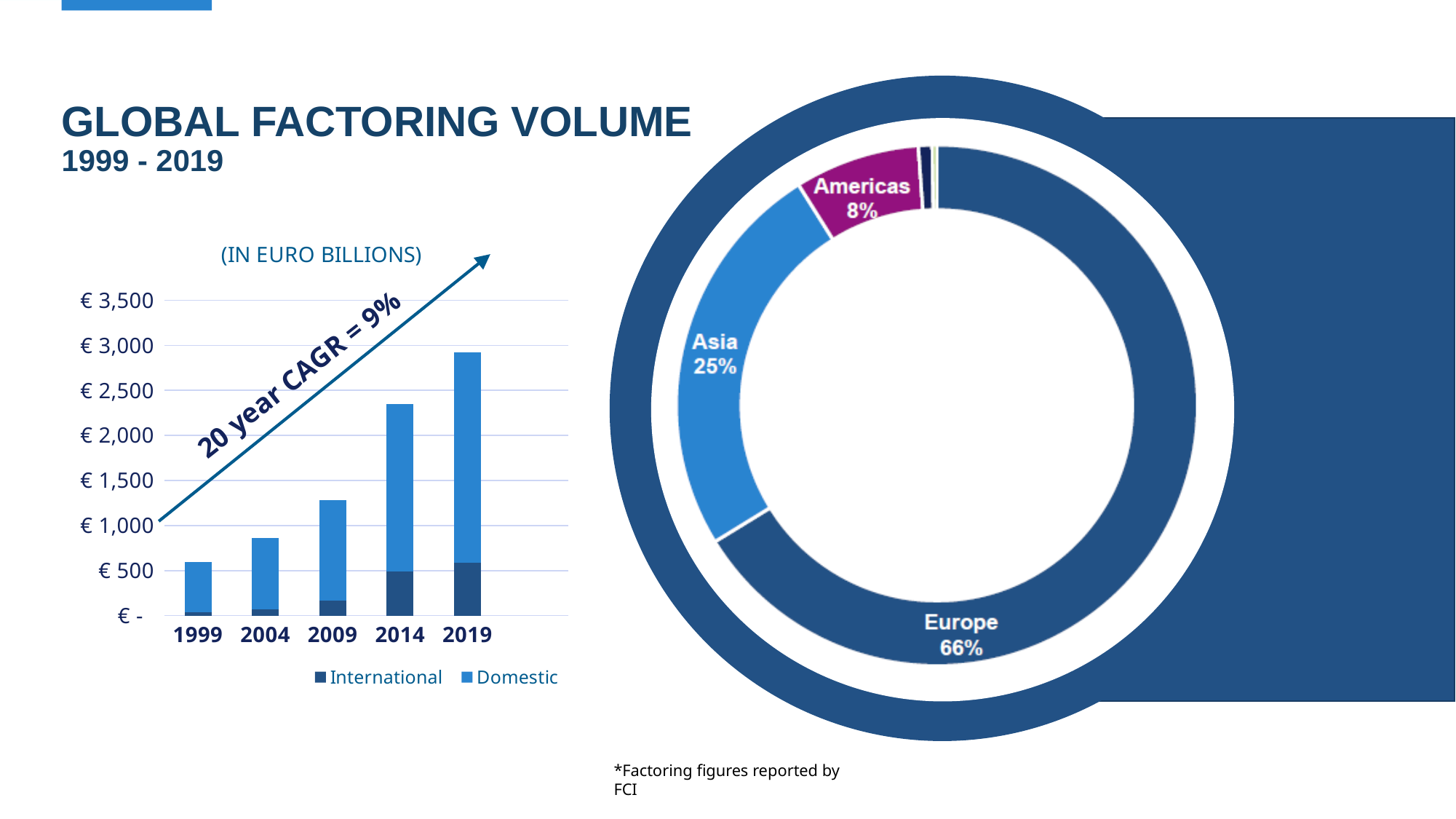
In the bar chart on the left, which year has the lowest total factoring volume? 1999 In the bar chart on the left, which year has the highest total factoring volume? 2019 In the donut chart on the right, what is the difference between the shares of Europe and Asia? 41% In the donut chart on the right, which has the larger share, Asia or Americas? Asia In the donut chart on the right, what share does Europe have? 66% In the bar chart on the left, is the total value for 2019 greater or less than € 2,500? greater What kind of chart is the chart on the right of the slide? Donut (pie) chart In the bar chart on the left, how many series does the legend list? 2 What kind of chart is the chart on the left of the slide? Stacked bar chart In the bar chart on the left, is the total value for 1999 greater or less than € 1,000? less In the bar chart on the left, how many years are shown on the x axis? 5 In the bar chart on the left, do the total values rise or fall from 1999 to 2019? rise